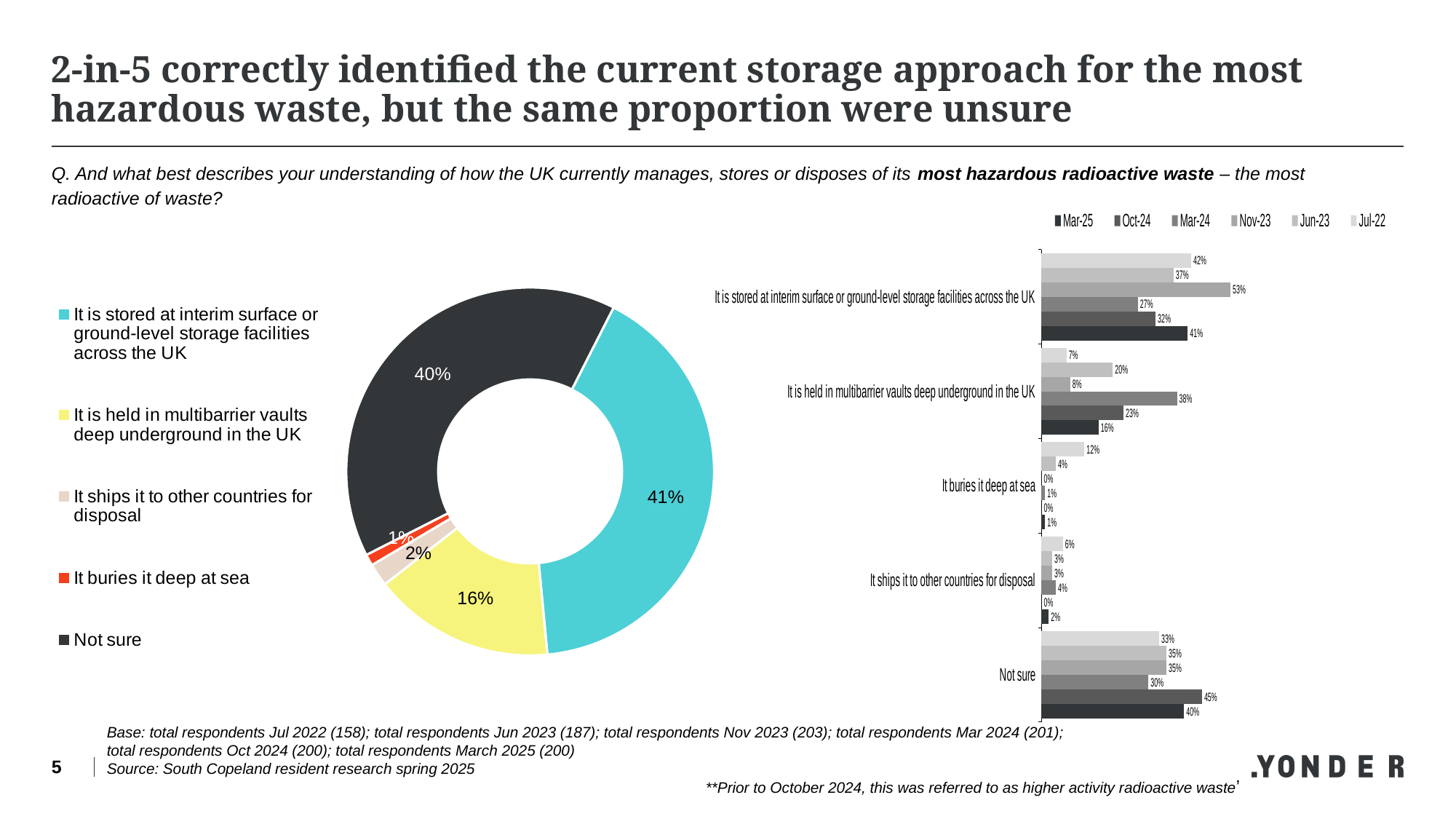
In the donut chart on the left, what percentage said it is held in multibarrier vaults deep underground in the UK? 16% In the donut chart on the left, which response has the smallest share? It buries it deep at sea What type of chart is shown on the right side of the slide? Bar chart In the donut chart on the left, what percentage of respondents answered 'Not sure'? 40% In the bar chart on the right, what is the Oct-24 value for 'Not sure'? 45% In the donut chart on the left, what percentage of respondents said the waste is stored at interim surface or ground-level storage facilities across the UK? 41% In the bar chart on the right, which wave has the highest value for 'It is stored at interim surface or ground-level storage facilities across the UK'? Nov-23 In the bar chart on the right, what is the Mar-24 value for 'It is held in multibarrier vaults deep underground in the UK'? 38% How many series does the legend of the bar chart on the right list? 6 In the bar chart on the right, what is the Mar-25 value for 'Not sure'? 40% In the donut chart on the left, what is the difference between the 'Not sure' share and the 'multibarrier vaults' share? 24 percentage points In the bar chart on the right, is the Oct-24 value for 'Not sure' larger or smaller than the Mar-25 value? larger